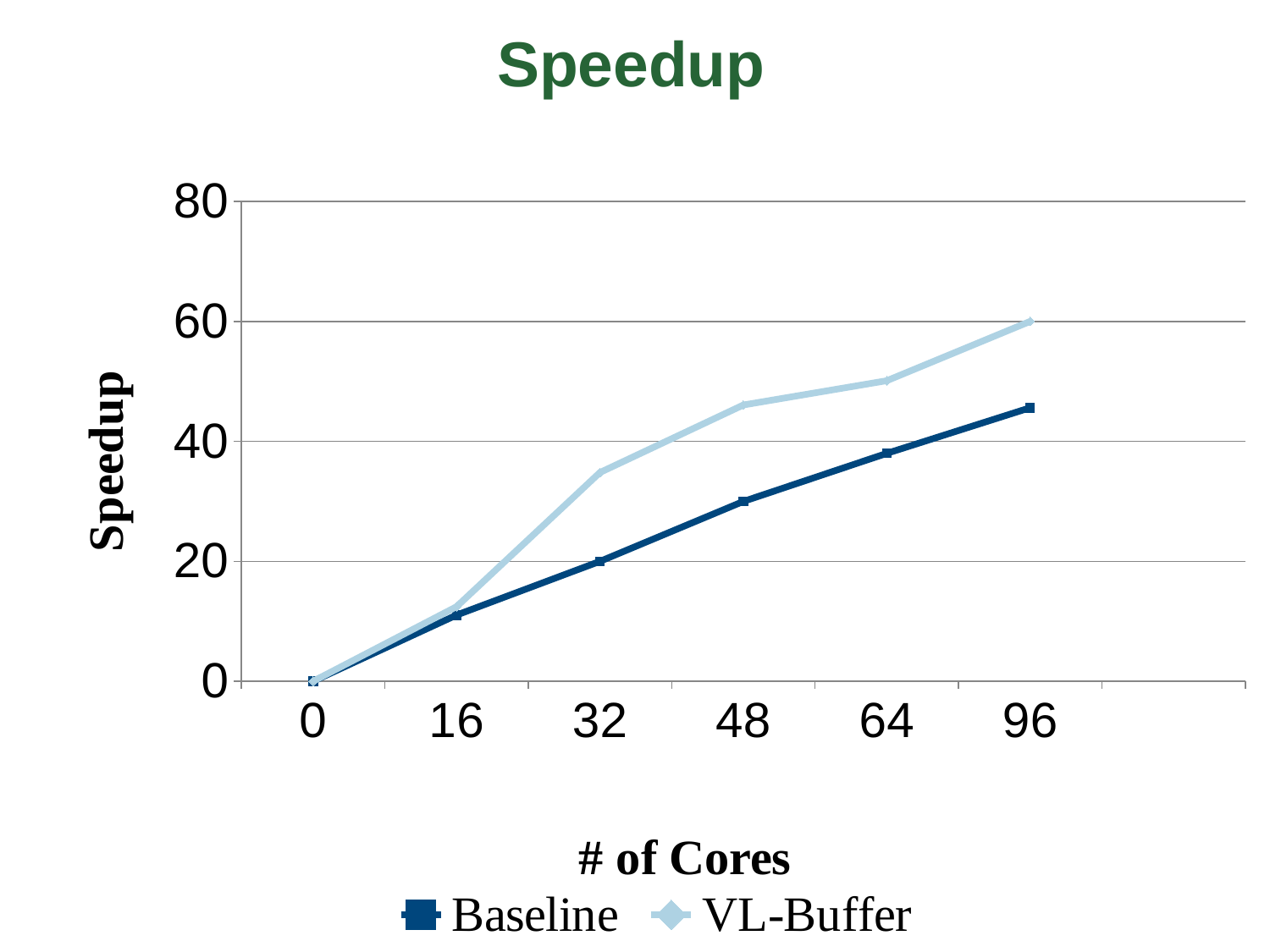
Is the VL-Buffer speedup at 32 cores greater or less than 40? less How many series does the legend list? 2 How many core counts are plotted along the x axis? 6 At 96 cores, which series has the higher speedup, Baseline or VL-Buffer? VL-Buffer Is the Baseline speedup at 96 cores greater or less than 40? greater What kind of chart is shown on the slide? line chart What is the Baseline speedup at 32 cores? 20 Is the Baseline speedup at 64 cores greater or less than 40? less What is the VL-Buffer speedup at 96 cores? 60 What is the title of the chart? Speedup Do the speedup values rise or fall as the number of cores increases? rise